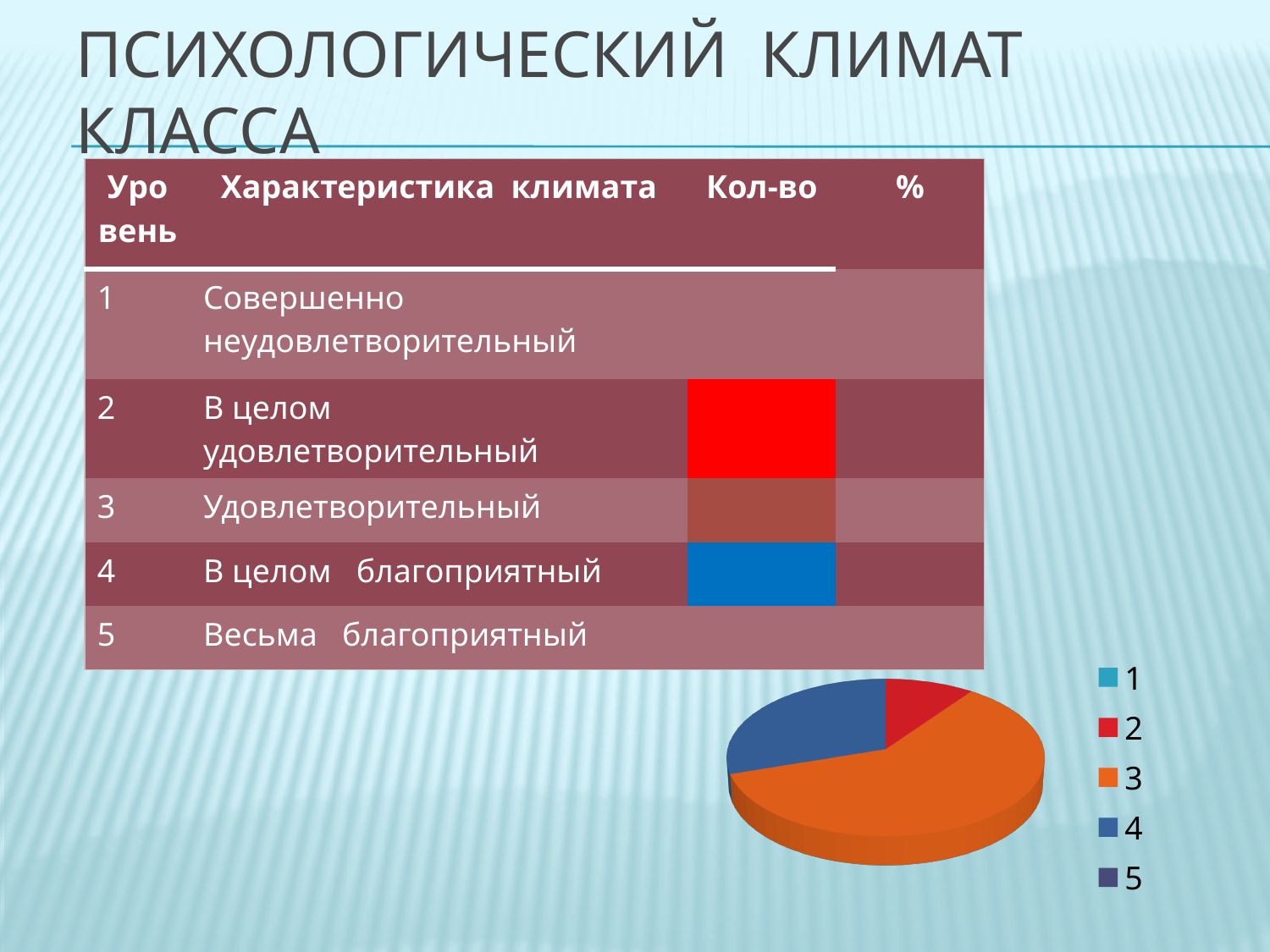
Which slice is larger in the pie chart, category 4 or category 2? 4 Which slice is larger in the pie chart, category 3 or category 4? 3 Which category has the largest slice in the pie chart? 3 What kind of chart is shown on the slide? pie chart What colour is the slice for category 2 in the pie chart? red Which slice is larger in the pie chart, category 3 or category 2? 3 What colour is the slice for category 3 in the pie chart? orange How many entries does the legend of the pie chart list? 5